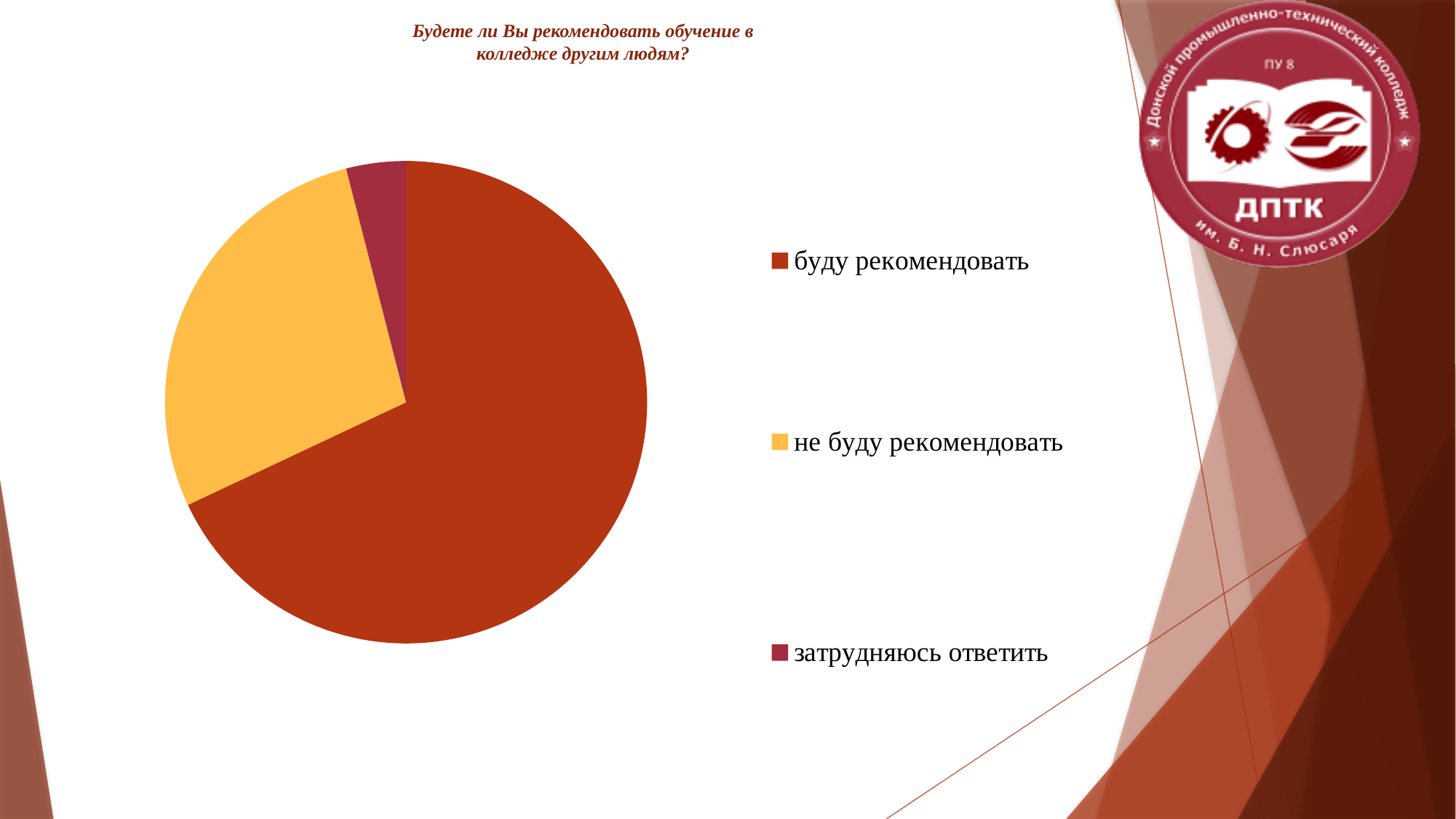
Which slice is larger: "буду рекомендовать" or "не буду рекомендовать"? буду рекомендовать Which category has the largest slice of the pie? буду рекомендовать Which category has the smallest slice of the pie? затрудняюсь ответить How many entries does the legend list? 3 Which slice is larger: "не буду рекомендовать" or "затрудняюсь ответить"? не буду рекомендовать What kind of chart is shown on the slide? pie chart Which category is shown in yellow in the pie chart? не буду рекомендовать What is the title of the chart? Будете ли Вы рекомендовать обучение в колледже другим людям? How many slices does the pie chart have? 3